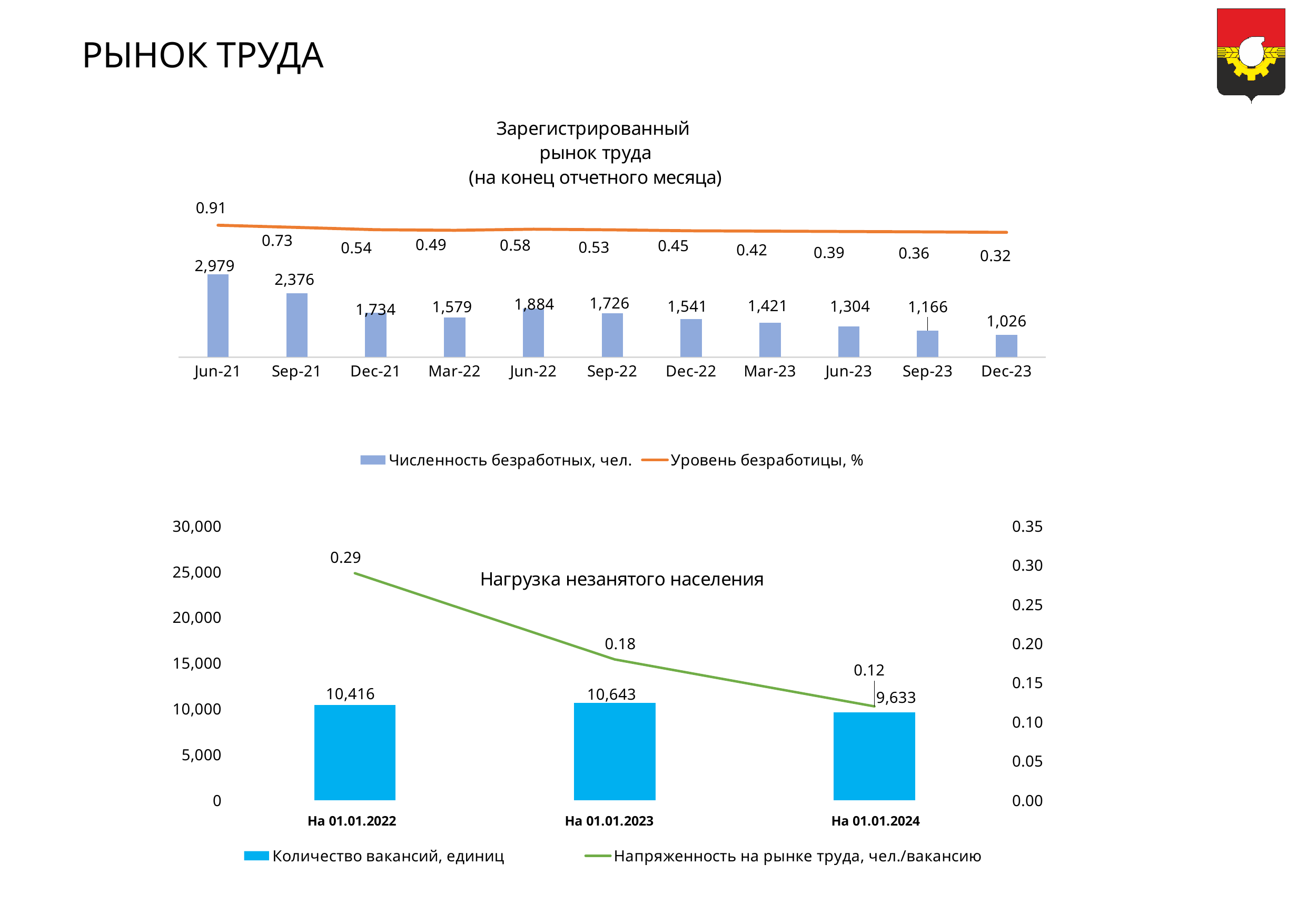
In the chart 'Зарегистрированный рынок труда', what is the value of 'Уровень безработицы, %' for Dec-23? 0.32 In the chart 'Зарегистрированный рынок труда', how many months are shown on the x axis? 11 In the chart 'Зарегистрированный рынок труда', what is the difference in 'Численность безработных, чел.' between Jun-22 and Sep-22? 158 In the chart 'Зарегистрированный рынок труда', which month has the highest value of 'Уровень безработицы, %'? Jun-21 In the chart 'Нагрузка незанятого населения', what is the value of 'Количество вакансий, единиц' for На 01.01.2023? 10,643 In the chart 'Нагрузка незанятого населения', which date has the lowest value of 'Количество вакансий, единиц'? На 01.01.2024 In the chart 'Нагрузка незанятого населения', what is the value of 'Напряженность на рынке труда, чел./вакансию' for На 01.01.2022? 0.29 In the chart 'Нагрузка незанятого населения', how many series does the legend list? 2 In the chart 'Зарегистрированный рынок труда', which month has the lowest value of 'Численность безработных, чел.'? Dec-23 In the chart 'Зарегистрированный рынок труда', what is the value of 'Численность безработных, чел.' for Jun-21? 2,979 In the chart 'Зарегистрированный рынок труда', does 'Уровень безработицы, %' generally rise or fall from Jun-21 to Dec-23? fall In the chart 'Нагрузка незанятого населения', what is the difference in 'Количество вакансий, единиц' between На 01.01.2023 and На 01.01.2024? 1,010